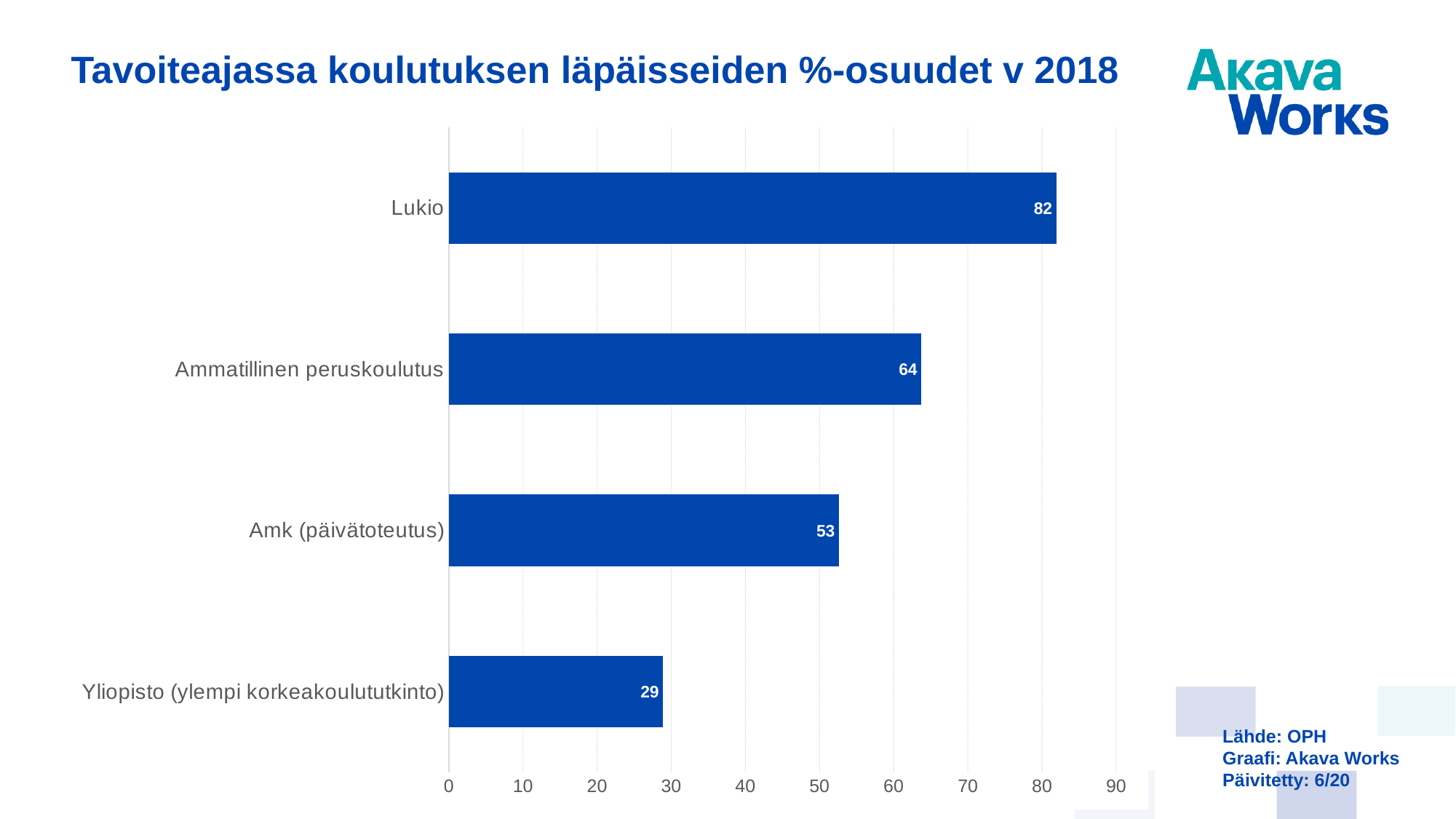
What kind of chart is shown on the slide? bar chart What is the difference between the values for Lukio and Yliopisto (ylempi korkeakoulututkinto)? 53 Which is larger, the value for Ammatillinen peruskoulutus or the value for Amk (päivätoteutus)? Ammatillinen peruskoulutus What is the value for Amk (päivätoteutus)? 53 Which category has the lowest value? Yliopisto (ylempi korkeakoulututkinto) What is the value for Ammatillinen peruskoulutus? 64 What is the value for Yliopisto (ylempi korkeakoulututkinto)? 29 What is the difference between the values for Ammatillinen peruskoulutus and Amk (päivätoteutus)? 11 Which category has the highest value? Lukio What is the value for Lukio? 82 Is the value for Amk (päivätoteutus) greater or less than 50? greater How many categories are shown in the chart? 4